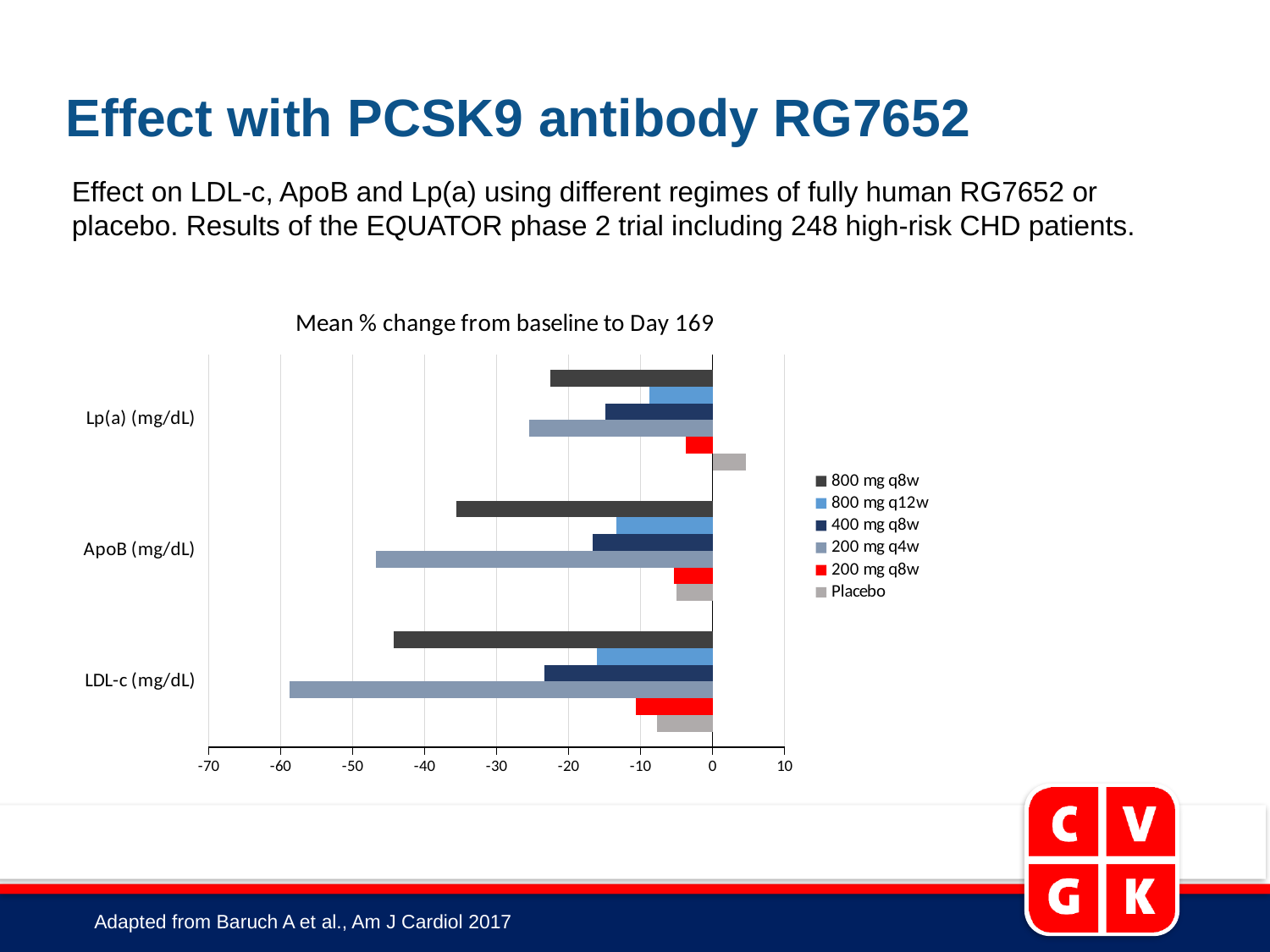
For LDL-c (mg/dL), which shows a larger reduction: 800 mg q8w or 800 mg q12w? 800 mg q8w For the 200 mg q4w series, which category shows the largest reduction? LDL-c (mg/dL) Which series is shown in red in the legend? 200 mg q8w How many categories are shown on the vertical axis of the chart? 3 Is the value for 800 mg q8w in ApoB (mg/dL) greater or less than -30? less Is the value for Placebo in Lp(a) (mg/dL) greater or less than 0? greater What is the title of the chart? Mean % change from baseline to Day 169 Is the value for 200 mg q4w in LDL-c (mg/dL) greater or less than -50? less Which series shows the largest reduction (most negative value) for LDL-c (mg/dL)? 200 mg q4w What type of chart is shown on the slide? bar chart How many series does the legend list? 6 For ApoB (mg/dL), which shows a larger reduction: 200 mg q4w or 400 mg q8w? 200 mg q4w